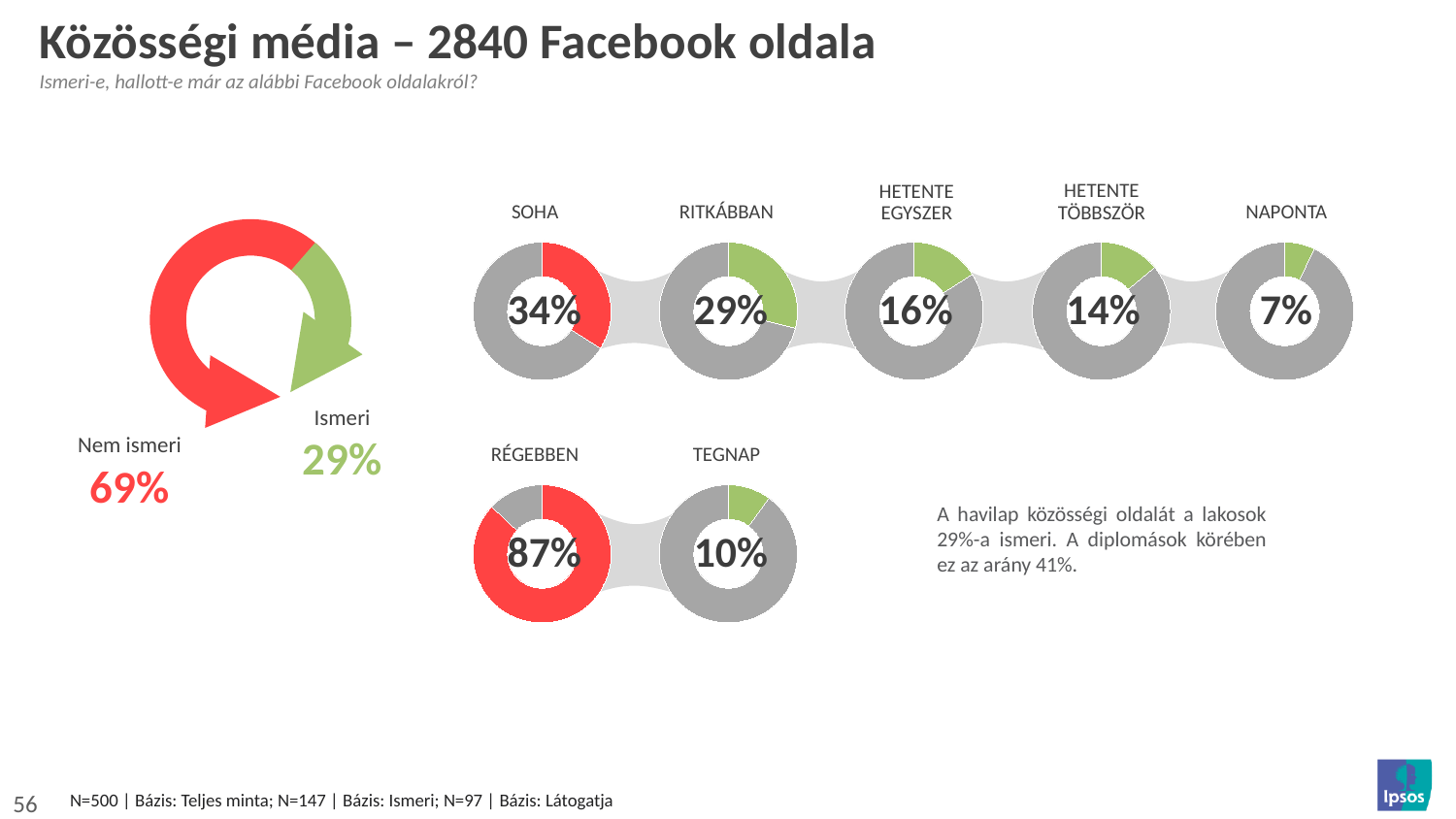
In the row of five small donut charts at the top, what is the difference between the "RITKÁBBAN" and "HETENTE EGYSZER" percentages? 13% In the row of five small donut charts at the top, what percentage is shown for "HETENTE TÖBBSZÖR"? 14% In the row of five small donut charts at the top, which category has the highest percentage? SOHA In the large donut chart on the left, which segment is larger, "Nem ismeri" or "Ismeri"? Nem ismeri In the pair of donut charts in the lower middle, what percentage is shown for "RÉGEBBEN"? 87% In the large donut chart on the left, what percentage is shown for "Ismeri"? 29% In the pair of donut charts in the lower middle, what percentage is shown for "TEGNAP"? 10% In the row of five small donut charts at the top, which category has the lowest percentage? NAPONTA In the row of five small donut charts at the top, what percentage is shown for "SOHA"? 34% How many small donut charts are in the top row (SOHA to NAPONTA)? 5 In the large donut chart on the left, what is the difference between the "Nem ismeri" and "Ismeri" percentages? 40% In the large donut chart on the left, what percentage is shown for "Nem ismeri"? 69%